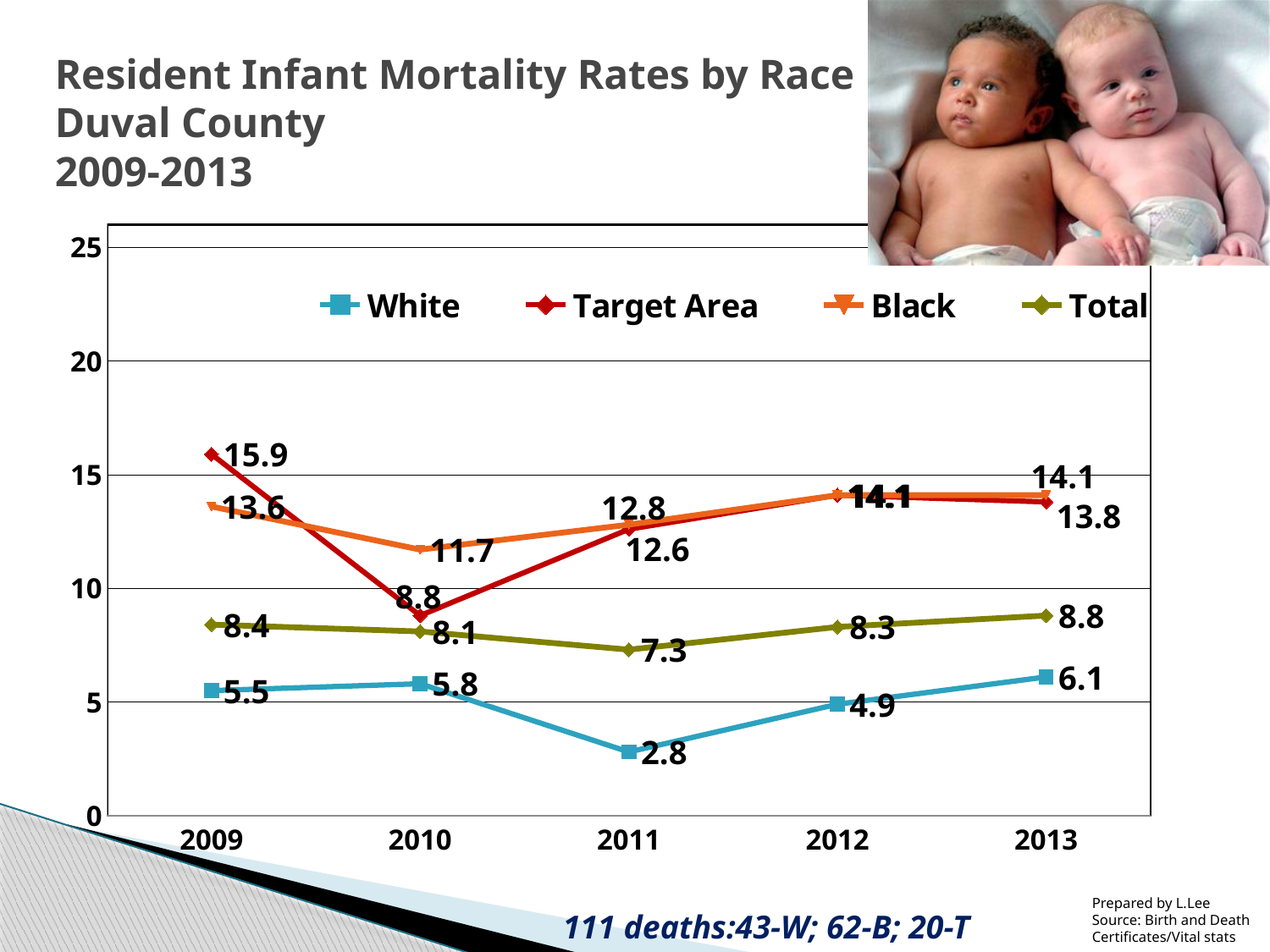
Which is larger in 2013, the Black rate or the Target Area rate? Black In which year is the White rate lowest? 2011 What is the Target Area infant mortality rate in 2009? 15.9 What is the Total infant mortality rate in 2013? 8.8 What is the Black infant mortality rate in 2010? 11.7 What is the White infant mortality rate in 2011? 2.8 How many series does the legend list? 4 What type of chart is shown on the slide? line chart In which year is the Target Area rate highest? 2009 Does the Total rate rise or fall from 2011 to 2013? rise What is the difference between the Target Area rate and the White rate in 2009? 10.4 How many years are plotted on the x axis? 5